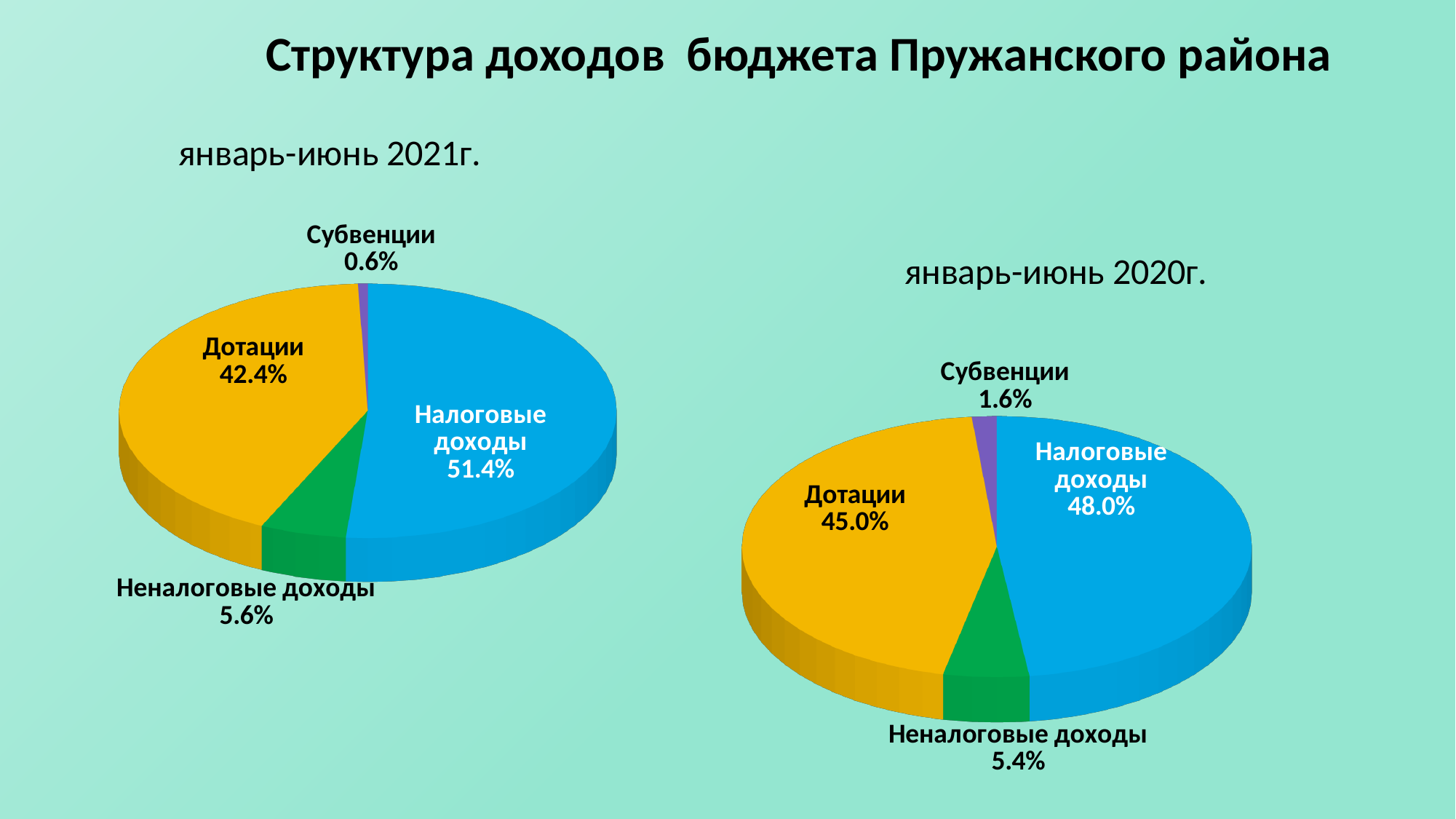
In the pie chart for январь-июнь 2021г., what share is Налоговые доходы? 51.4% In the pie chart for январь-июнь 2021г., what share is Субвенции? 0.6% In the pie chart for январь-июнь 2021г., what is the difference between the shares of Налоговые доходы and Дотации? 9.0% What is the title of the slide containing the two pie charts? Структура доходов бюджета Пружанского района In the pie chart for январь-июнь 2020г., which is larger: Дотации or Налоговые доходы? Налоговые доходы In the pie chart for январь-июнь 2020г., which category has the smallest share? Субвенции In the pie chart for январь-июнь 2020г., what share is Неналоговые доходы? 5.4% What type of chart is used for январь-июнь 2020г.? Pie chart How many slices does the pie chart for январь-июнь 2021г. have? 4 In the pie chart for январь-июнь 2021г., which category has the largest share? Налоговые доходы In the pie chart for январь-июнь 2020г., what colour is the Дотации slice? Yellow In the pie chart for январь-июнь 2020г., what share is Дотации? 45.0%